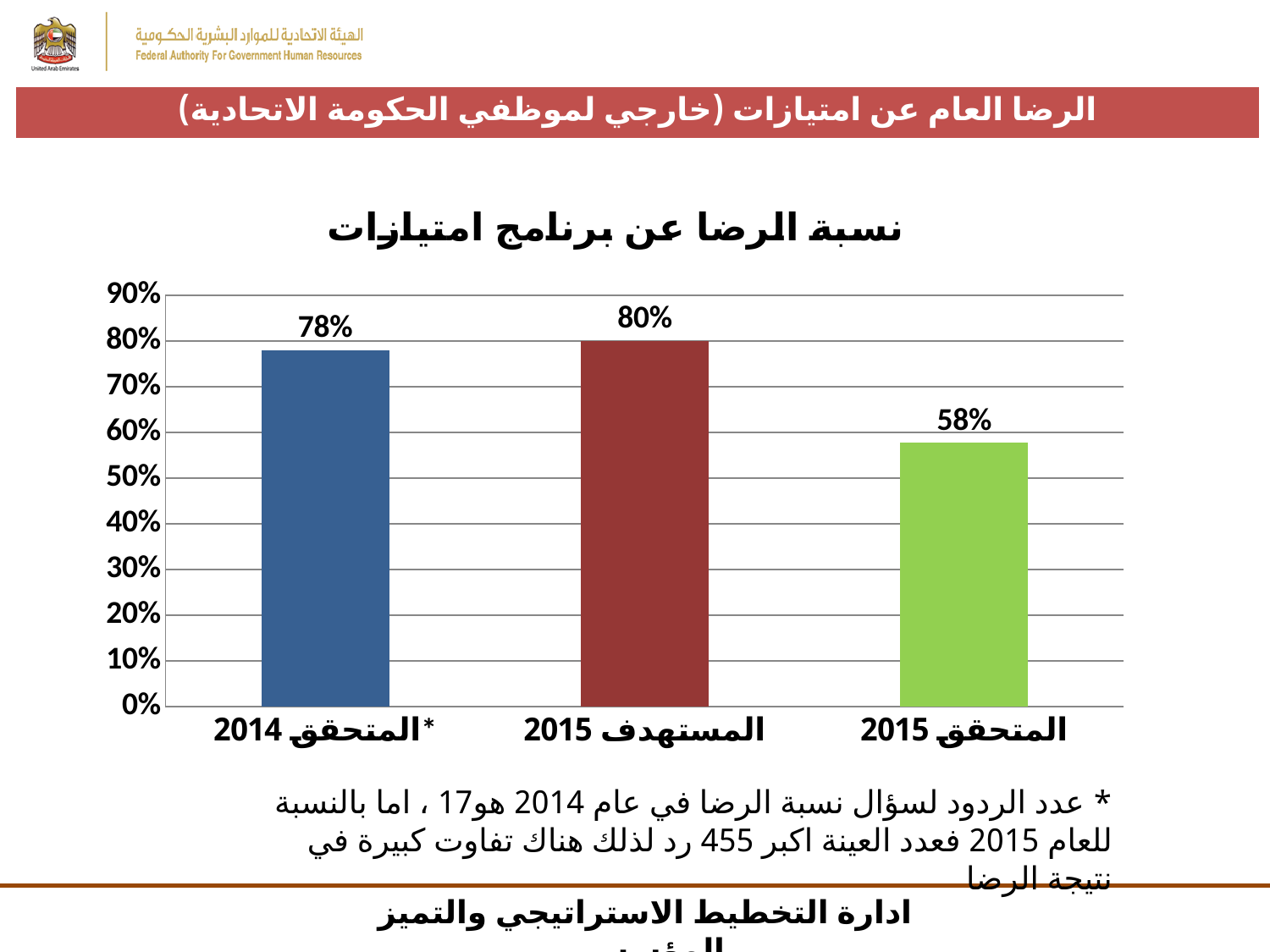
How many categories are shown in the chart? 3 What is the title of the chart? نسبة الرضا عن برنامج امتيازات What kind of chart is shown on the slide? bar chart Is the value for المتحقق 2015 greater or less than 60%? less What is the difference between the values for المستهدف 2015 and المتحقق 2014*? 2% Which category has the highest value in the chart? المستهدف 2015 What is the difference between the values for المستهدف 2015 and المتحقق 2015? 22% What is the value for المستهدف 2015 in the chart? 80% What is the value for المتحقق 2015 in the chart? 58% Which is larger, the value for المتحقق 2014* or the value for المتحقق 2015? المتحقق 2014* What is the value for المتحقق 2014* in the chart? 78% Which category has the lowest value in the chart? المتحقق 2015